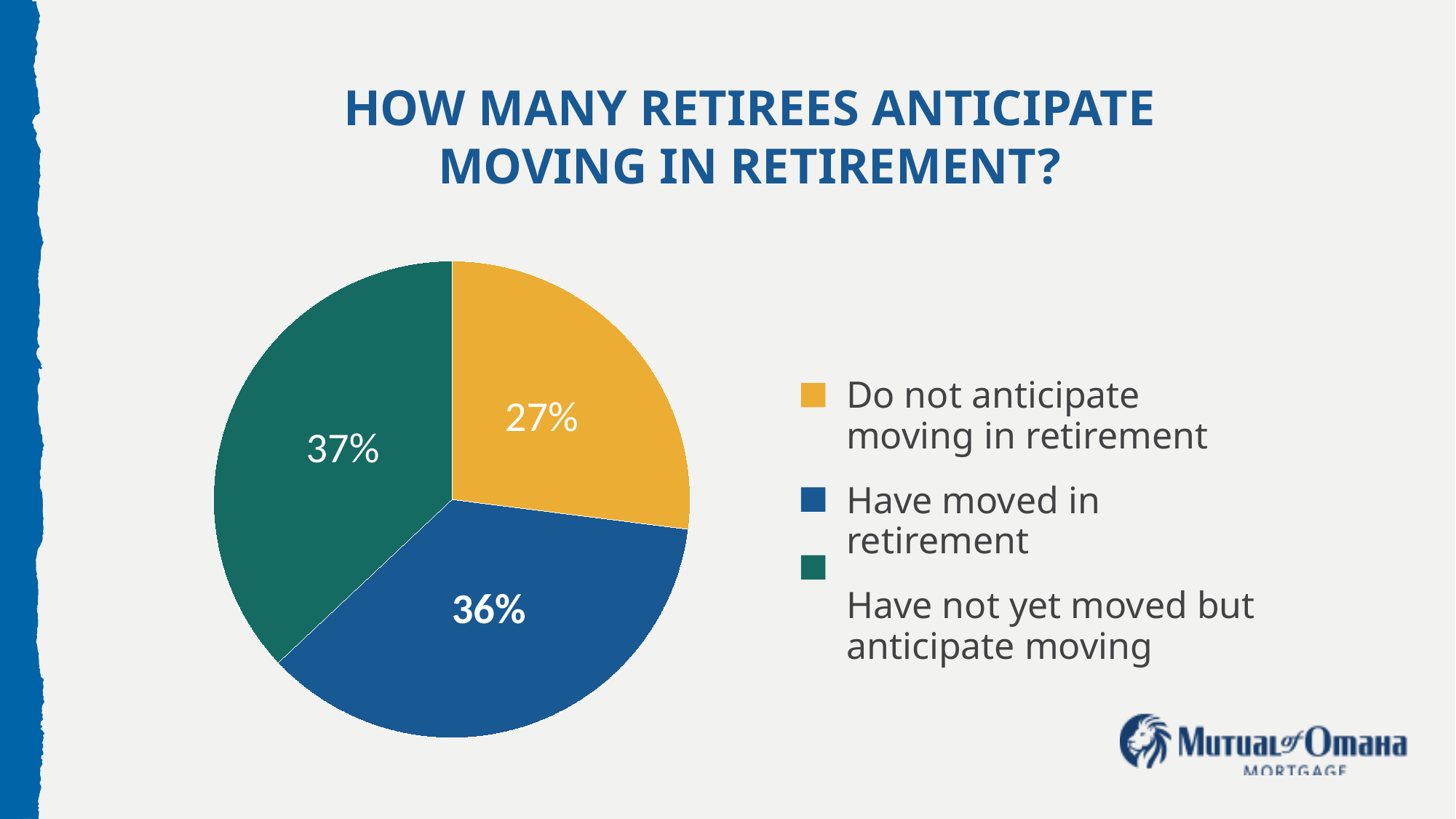
How many categories does the pie chart show? 3 What is the title of the chart on the slide? How many retirees anticipate moving in retirement? Which is larger: the share that have moved in retirement or the share that do not anticipate moving in retirement? Have moved in retirement Which category has the largest share of the pie? Have not yet moved but anticipate moving What share of retirees have not yet moved but anticipate moving? 37% What is the difference in percentage points between 'Have moved in retirement' and 'Do not anticipate moving in retirement'? 9 percentage points What is the difference in percentage points between 'Have not yet moved but anticipate moving' and 'Do not anticipate moving in retirement'? 10 percentage points What share of retirees have moved in retirement? 36% What kind of chart is shown on the slide? Pie chart Which category has the smallest share of the pie? Do not anticipate moving in retirement What colour is the slice for 'Have moved in retirement'? Blue What share of retirees do not anticipate moving in retirement? 27%